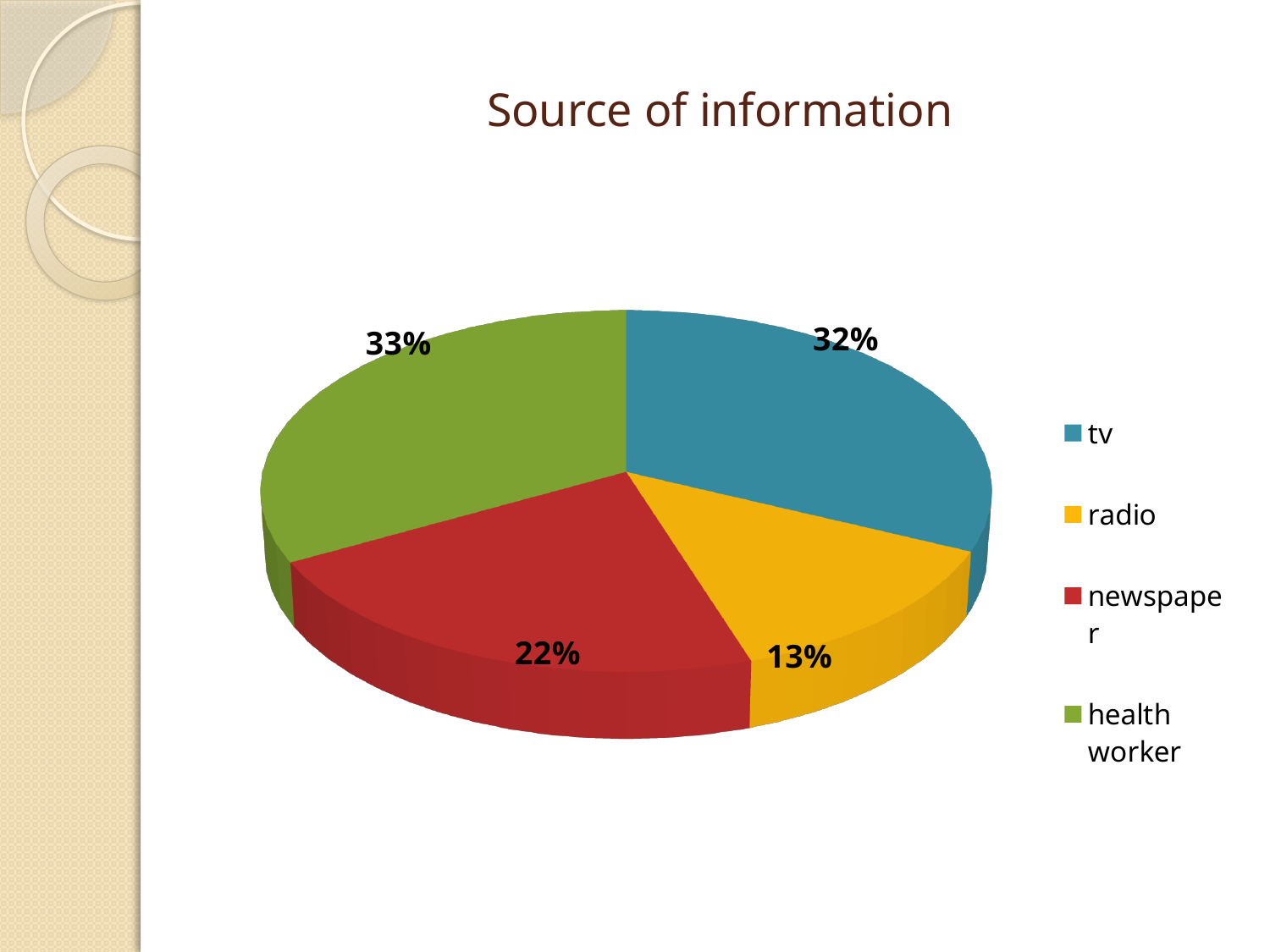
What kind of chart is shown on the slide? pie chart What share of the pie does health worker account for? 33% What share of the pie does tv account for? 32% What is the title of the chart? Source of information Which source of information has the smallest slice? radio Which source of information has the largest slice? health worker What is the difference in percentage points between the newspaper slice and the radio slice? 9 What is the difference in percentage points between the health worker slice and the tv slice? 1 What share of the pie does newspaper account for? 22% How many slices does the pie chart have? 4 Which is larger, the tv slice or the newspaper slice? tv